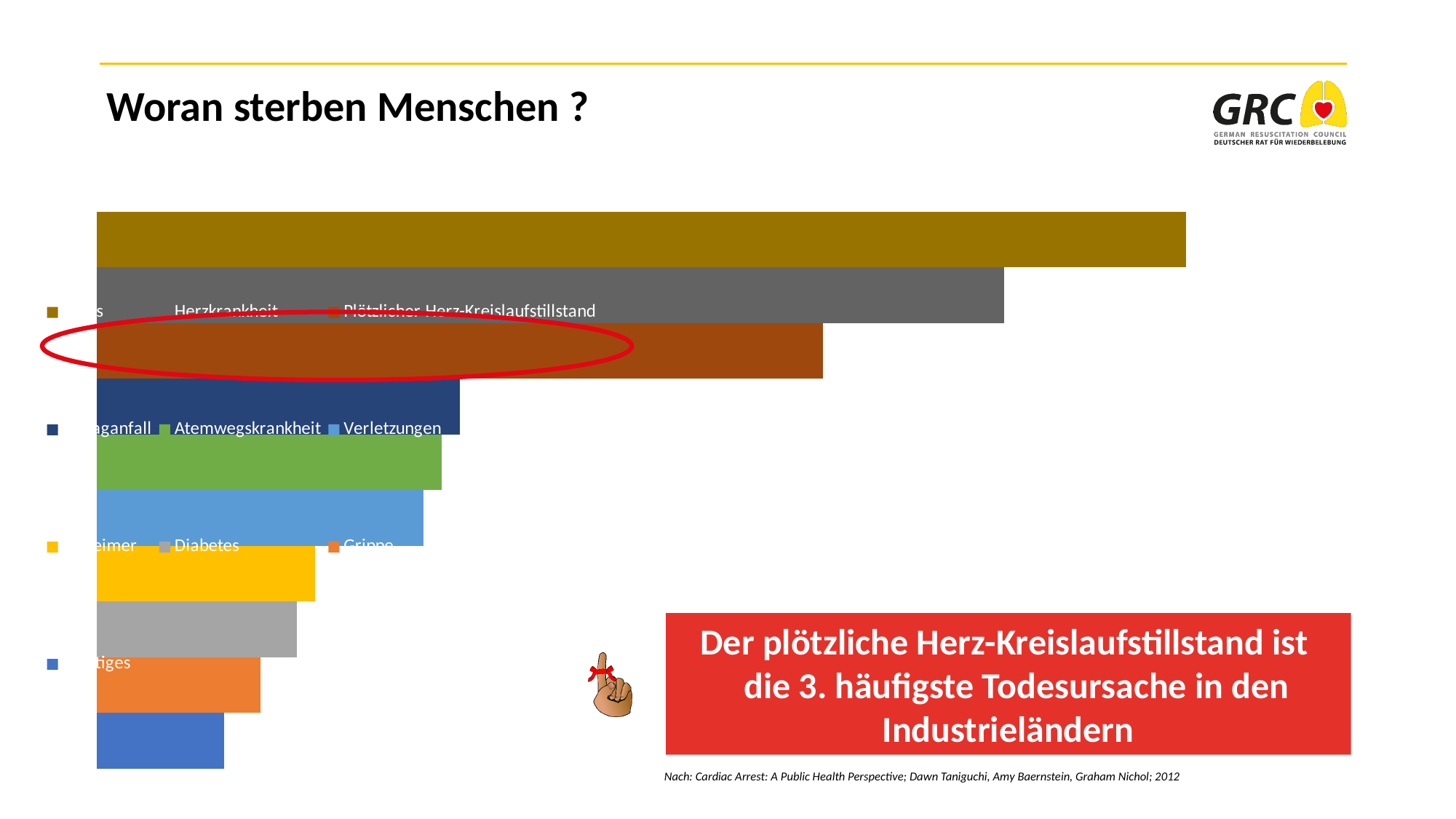
Which bar is circled in red on the chart? Plötzlicher Herz-Kreislaufstillstand What is the title of the slide containing the chart? Woran sterben Menschen ? What kind of chart is shown on the slide? bar chart Which is larger, the value for Plötzlicher Herz-Kreislaufstillstand or the value for Atemwegskrankheit? Plötzlicher Herz-Kreislaufstillstand Which is larger, the value for Herzkrankheit or the value for Diabetes? Herzkrankheit Which is larger, the value for Herzkrankheit or the value for Plötzlicher Herz-Kreislaufstillstand? Herzkrankheit How many bars does the chart contain? 10